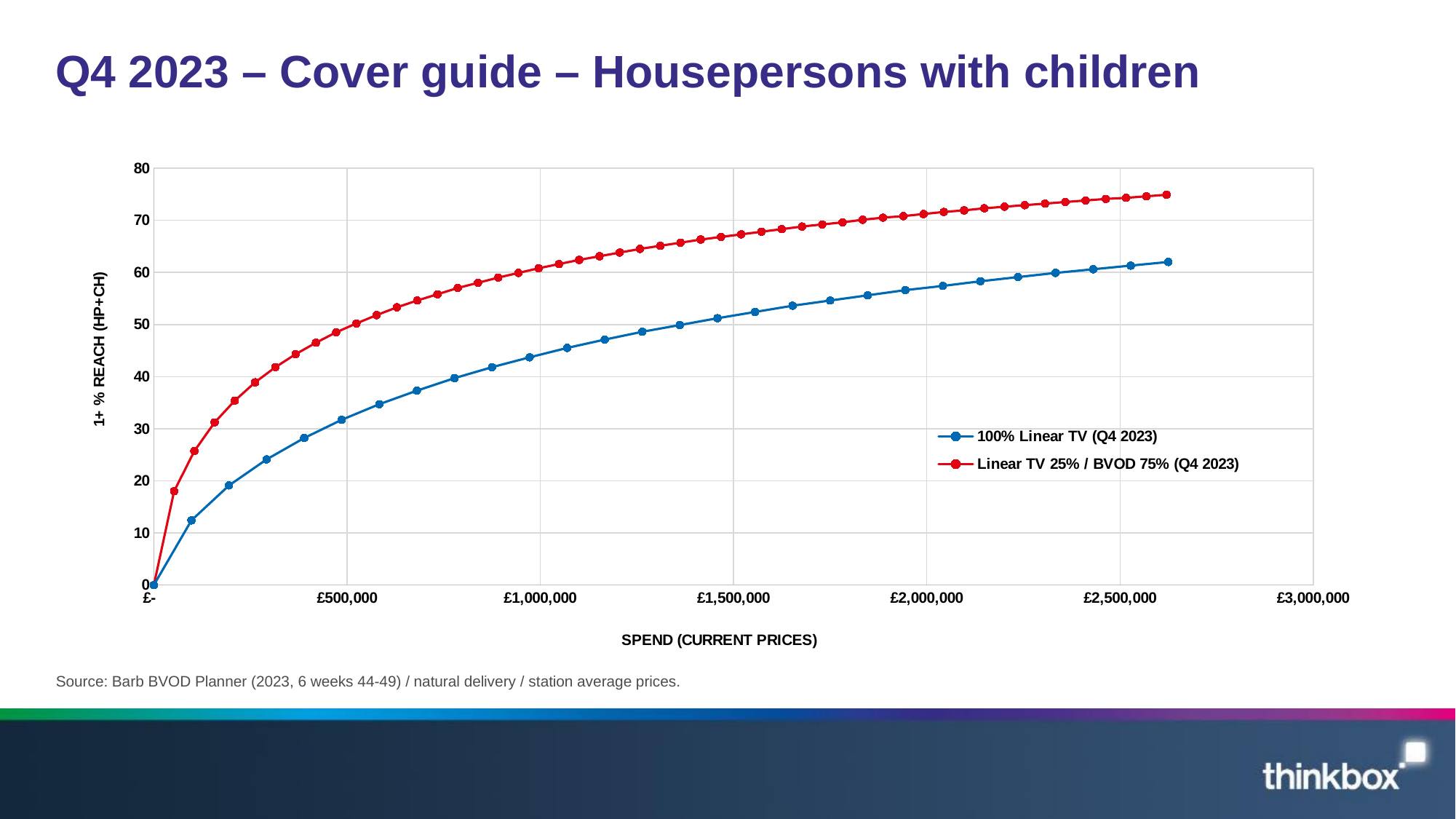
Is the 1+ % reach for 100% Linear TV (Q4 2023) at a spend of £500,000 greater or less than 40? less How many series does the legend list? 2 At a spend of £1,000,000, which series has the higher 1+ % reach: 100% Linear TV (Q4 2023) or Linear TV 25% / BVOD 75% (Q4 2023)? Linear TV 25% / BVOD 75% (Q4 2023) Is the 1+ % reach for 100% Linear TV (Q4 2023) at a spend of £2,500,000 greater or less than 70? less What kind of chart is shown on the slide? line chart Does the 1+ % reach for 100% Linear TV (Q4 2023) rise or fall as spend increases? rise Is the 1+ % reach for Linear TV 25% / BVOD 75% (Q4 2023) at a spend of £2,500,000 greater or less than 70? greater What is the 1+ % reach for both series at a spend of £-? 0 Which colour is used for the Linear TV 25% / BVOD 75% (Q4 2023) series? red What is the label of the vertical axis? 1+ % REACH (HP+CH) Which series reaches the highest 1+ % reach on the chart? Linear TV 25% / BVOD 75% (Q4 2023)